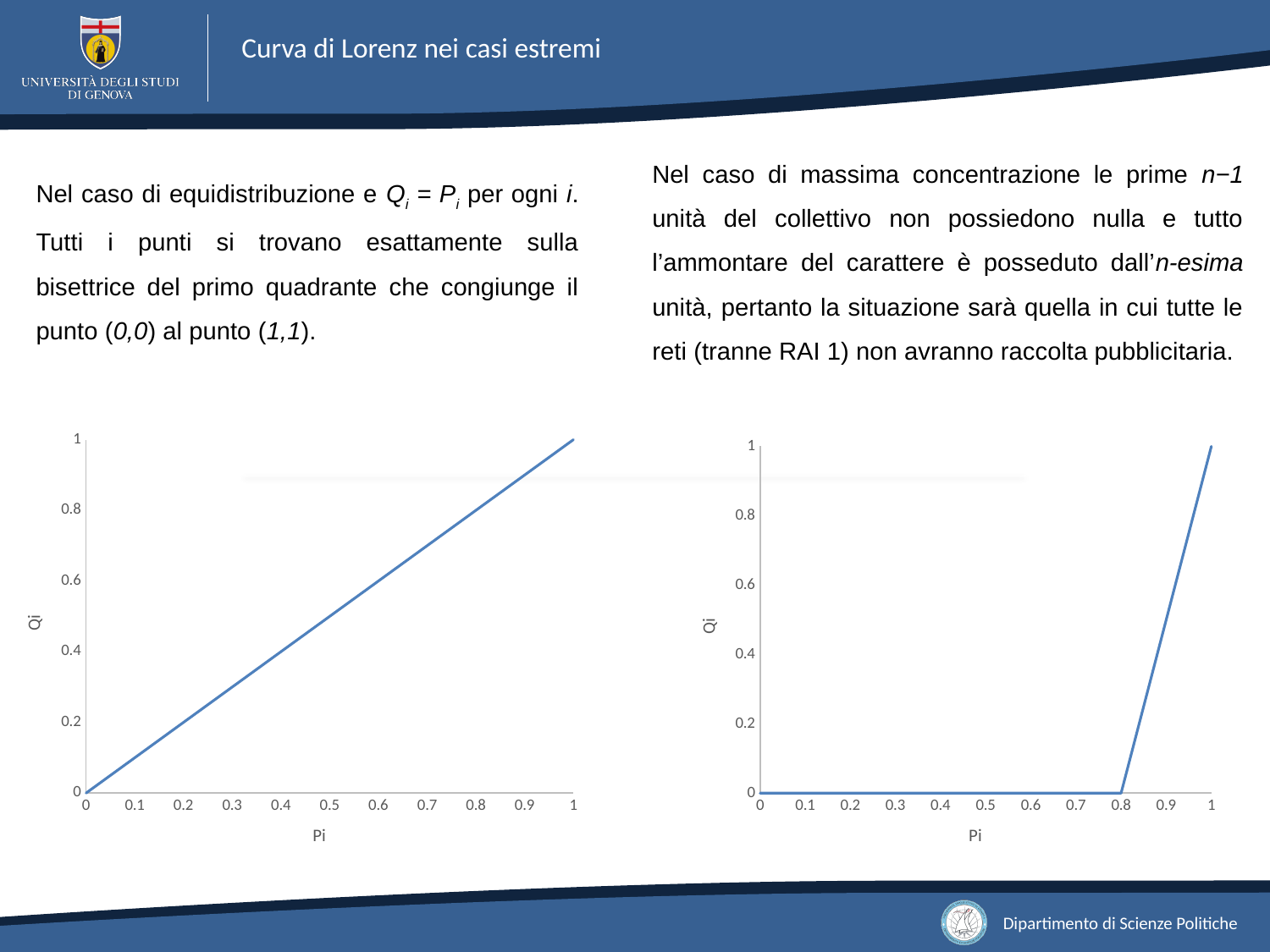
In the right chart, is the value of Qi at Pi = 0.5 greater or less than 0.2? less What kind of chart is the chart on the right of the slide? line chart In the right chart, what is the value of Qi when Pi is 1? 1 In the left chart, is the value of Qi at Pi = 0.9 greater or less than 0.8? greater What kind of chart is the chart on the left of the slide? line chart In the left chart, do the values of Qi rise or fall as Pi increases? rise In the left chart, what is the value of Qi when Pi is 0? 0 In the right chart, what is the value of Qi when Pi is 0.8? 0 What is the label of the horizontal axis in the left chart? Pi In the right chart, at which value of Pi does the line start to rise above 0? 0.8 In the left chart, what is the value of Qi when Pi is 1? 1 What is the label of the vertical axis in the right chart? Qi